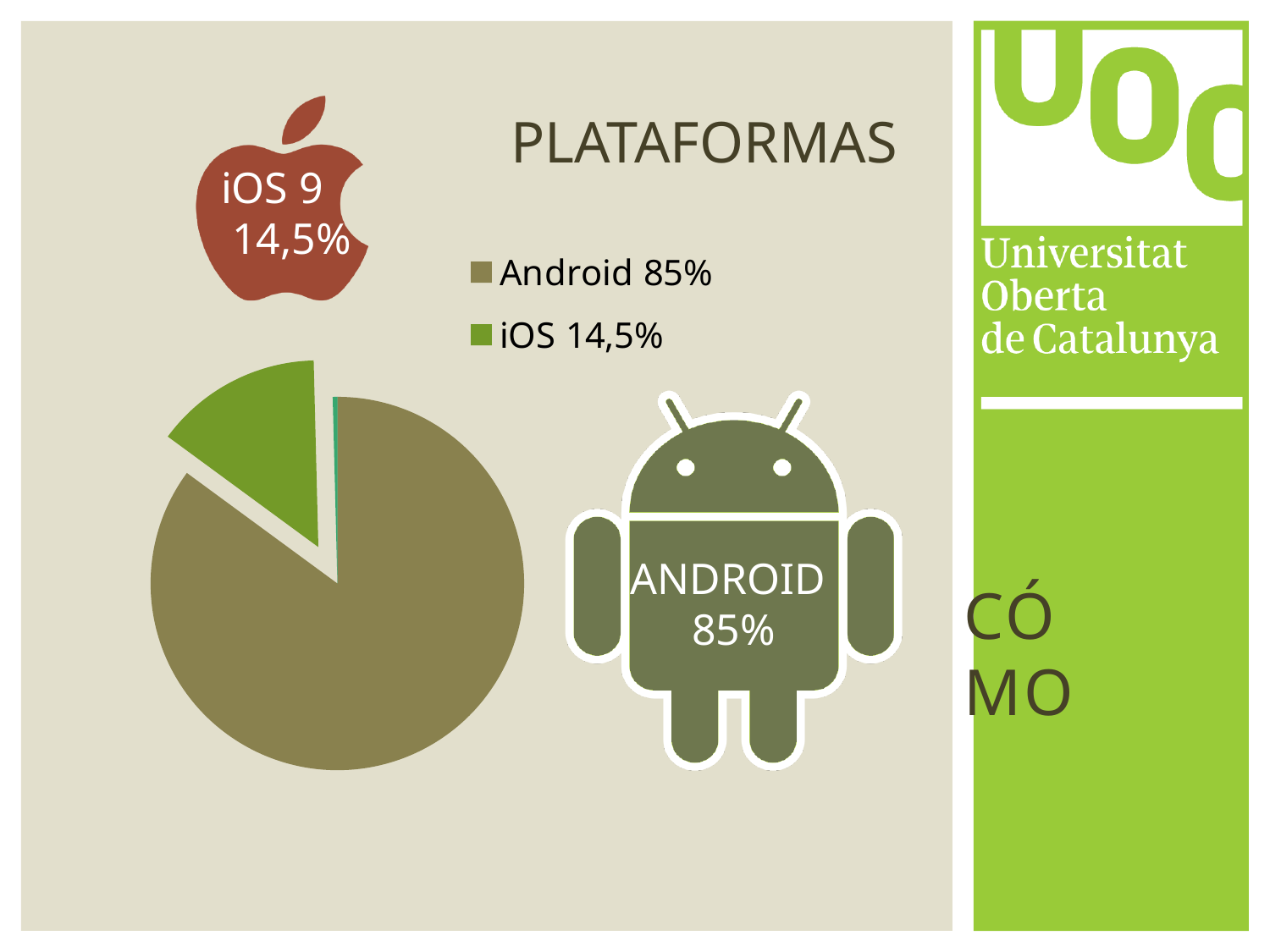
Which platform has the largest slice of the pie? Android What share of the pie does the Android slice represent? 85% What percentage does the legend give for Android? 85% What kind of chart is shown on the slide? pie chart What is the title of the chart? PLATAFORMAS What is the difference between the Android share and the iOS share? 70,5% What percentage does the legend give for iOS? 14,5% Which is larger, the share for Android or the share for iOS? Android How many entries does the legend list? 2 Which platform has the smallest share according to the legend? iOS Which colour is used for the iOS slice in the legend? green